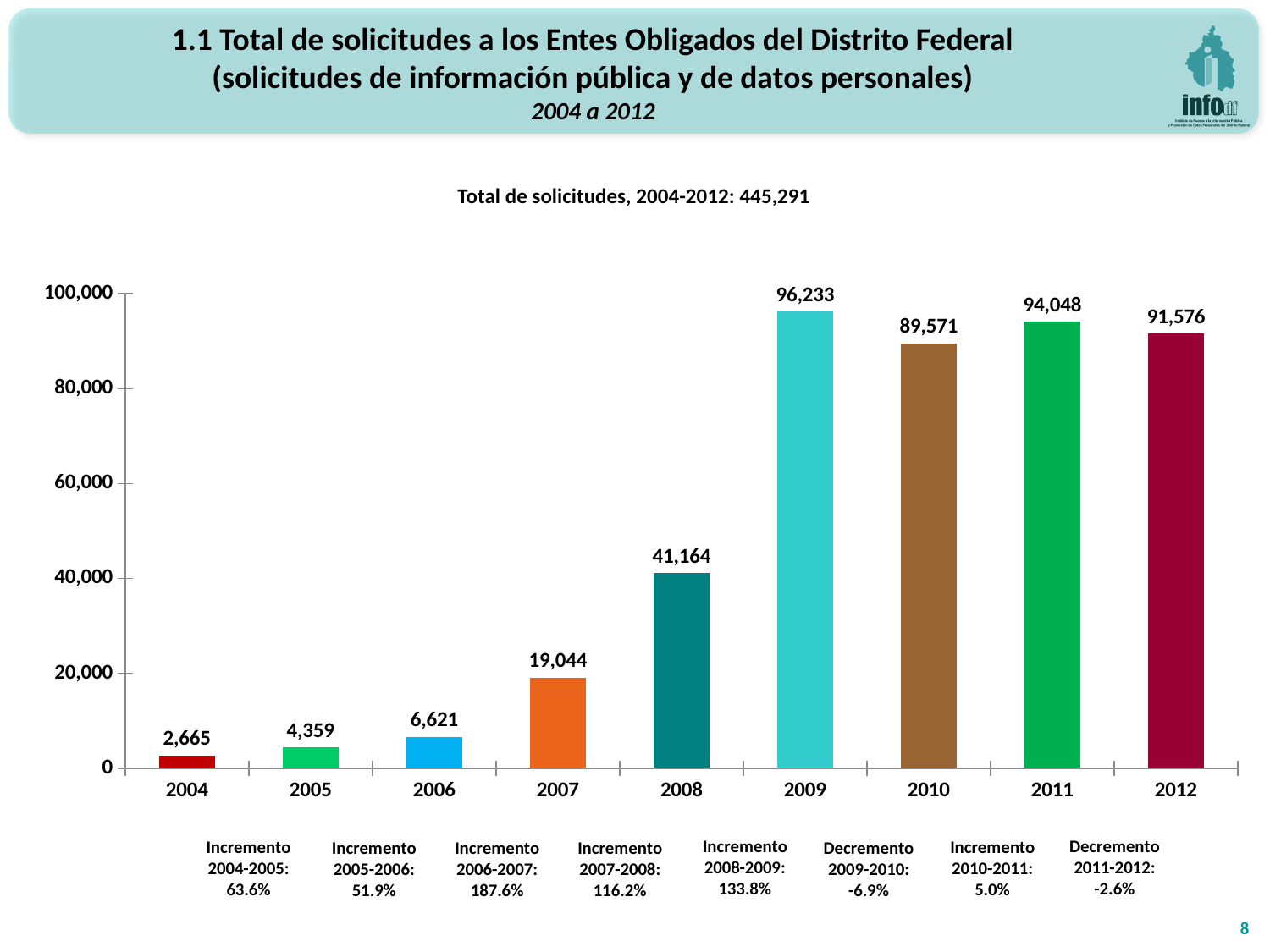
Which is larger, the value for 2008 or the value for 2012? 2012 What is the value for 2004? 2,665 How many years are shown on the x axis? 9 Is the value for 2010 greater or less than 80,000? greater What total for 2004-2012 is stated above the chart? 445,291 Do the values rise or fall from 2004 to 2009? rise What kind of chart is shown on the slide? bar chart What is the value for 2007? 19,044 What is the difference between the values for 2011 and 2010? 4,477 Which year has the lowest value? 2004 What is the value for 2009? 96,233 Which year has the highest value? 2009